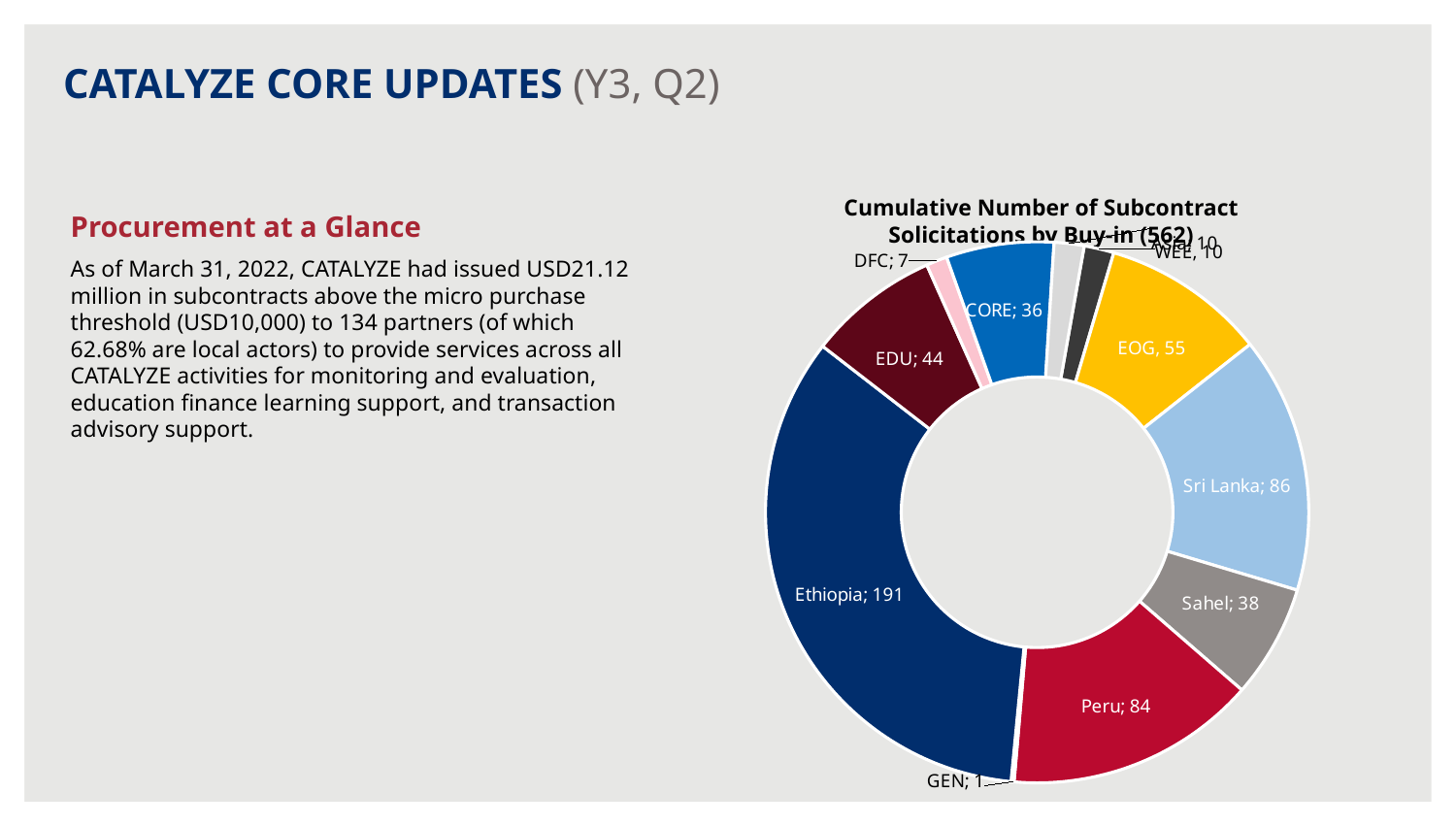
What is the value shown for Sri Lanka? 86 Which buy-in has the largest number of subcontract solicitations? Ethiopia Which buy-in has the smallest number of subcontract solicitations? GEN What is the value shown for CORE? 36 What is the value shown for Sahel? 38 What is the value shown for Peru in the chart? 84 What is the difference between the values for Ethiopia and Peru? 107 What cumulative total of subcontract solicitations is given in the chart title? 562 What is the value shown for EDU? 44 Which has a larger value, EDU or Sahel? EDU How many subcontract solicitations does the chart show for Ethiopia? 191 What kind of chart is shown on the slide? Doughnut (pie) chart